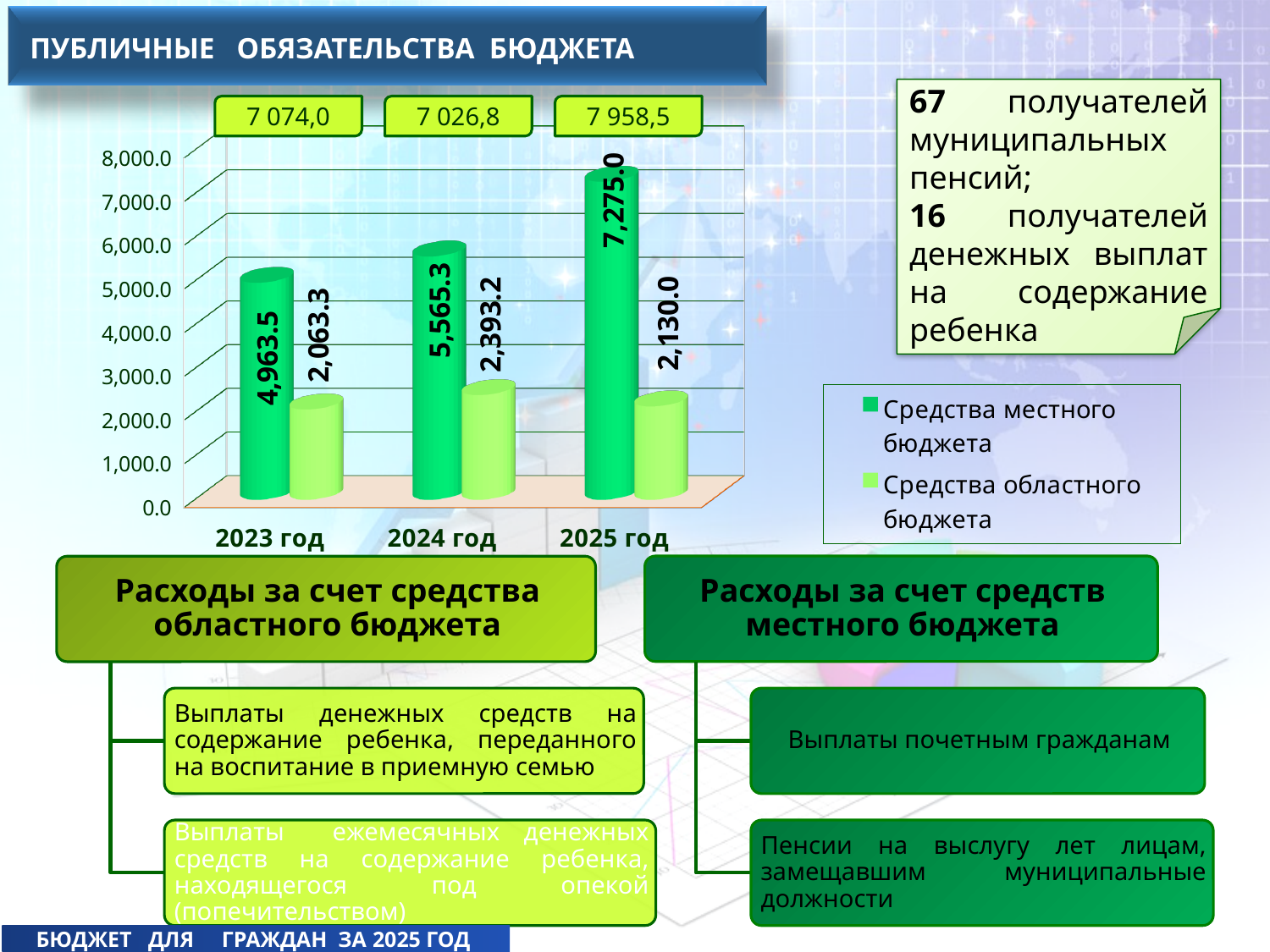
What is the difference between Средства местного бюджета and Средства областного бюджета in 2024 год? 3,172.1 What is the value for Средства областного бюджета in 2024 год? 2,393.2 Which year has the lowest value for Средства областного бюджета? 2023 год How many years are shown on the x axis of the chart? 3 Is the value for Средства местного бюджета in 2025 год greater or less than 7,000.0? greater Which is larger in 2023 год: Средства местного бюджета or Средства областного бюджета? Средства местного бюджета What is the value for Средства местного бюджета in 2023 год? 4,963.5 What is the value for Средства местного бюджета in 2025 год? 7,275.0 What is the value for Средства областного бюджета in 2025 год? 2,130.0 What kind of chart is shown on the slide? bar chart How many series does the chart legend list? 2 Which year has the highest value for Средства местного бюджета? 2025 год